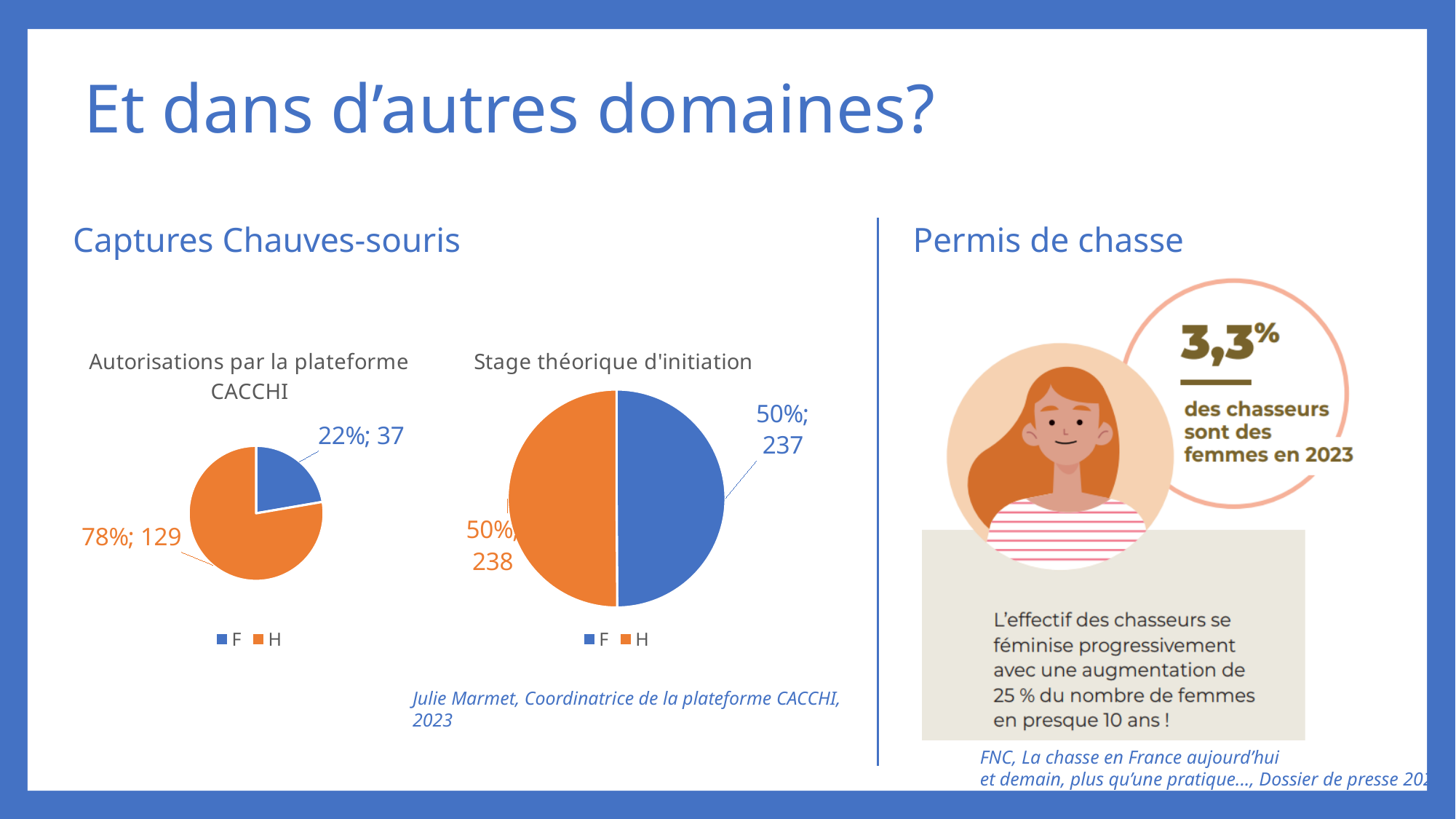
In the 'Autorisations par la plateforme CACCHI' chart, what share of the pie does F represent? 22% In the 'Autorisations par la plateforme CACCHI' chart, which category has the largest slice? H In the 'Stage théorique d'initiation' chart, what is the difference between the counts for H and F? 1 In the 'Autorisations par la plateforme CACCHI' chart, what value is shown for F? 22%; 37 In the 'Stage théorique d'initiation' chart, what count is shown for H? 238 What type of chart is 'Stage théorique d'initiation'? Pie chart In the 'Stage théorique d'initiation' chart, what count is shown for F? 237 In the 'Autorisations par la plateforme CACCHI' chart, what value is shown for H? 78%; 129 How many entries does the legend of the 'Autorisations par la plateforme CACCHI' chart list? 2 In the 'Autorisations par la plateforme CACCHI' chart, which category has the smallest slice? F In the 'Autorisations par la plateforme CACCHI' chart, what is the difference between the counts for H and F? 92 In the 'Stage théorique d'initiation' chart, what share of the pie does H represent? 50%